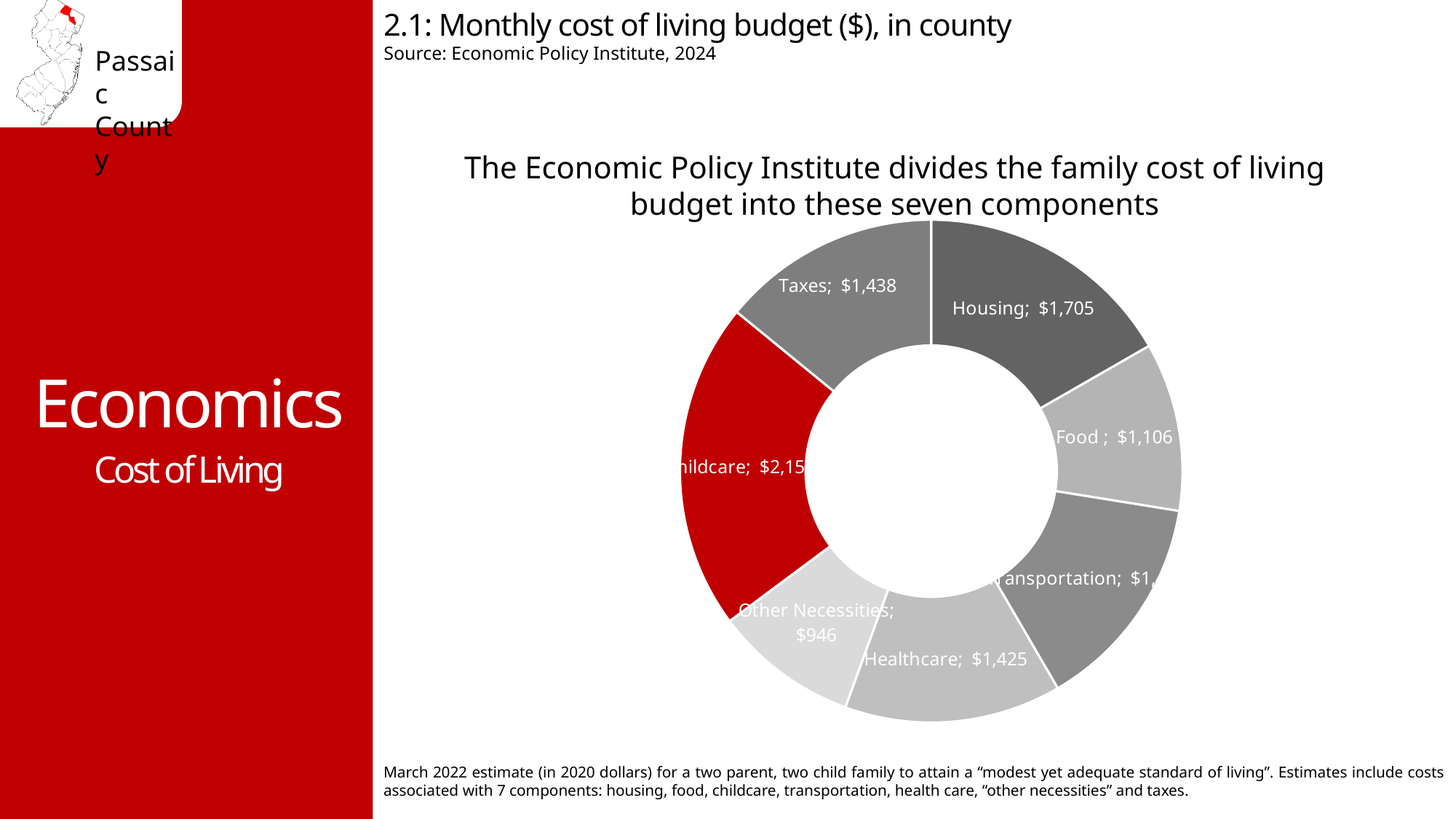
What is the monthly cost for Other Necessities in the chart? $946 Which component has the smallest monthly cost in the chart? Other Necessities How many components are shown in the chart? 7 Which component has the largest monthly cost in the chart? Childcare Which is larger, the monthly cost for Housing or for Taxes? Housing What is the difference between the Healthcare and Other Necessities monthly costs? $479 What is the monthly cost for Healthcare in the chart? $1,425 What is the monthly cost for Housing in the chart? $1,705 What is the monthly cost for Taxes in the chart? $1,438 What is the difference between the Housing and Food monthly costs? $599 What is the monthly cost for Food in the chart? $1,106 What kind of chart is shown on the slide? Doughnut (pie) chart